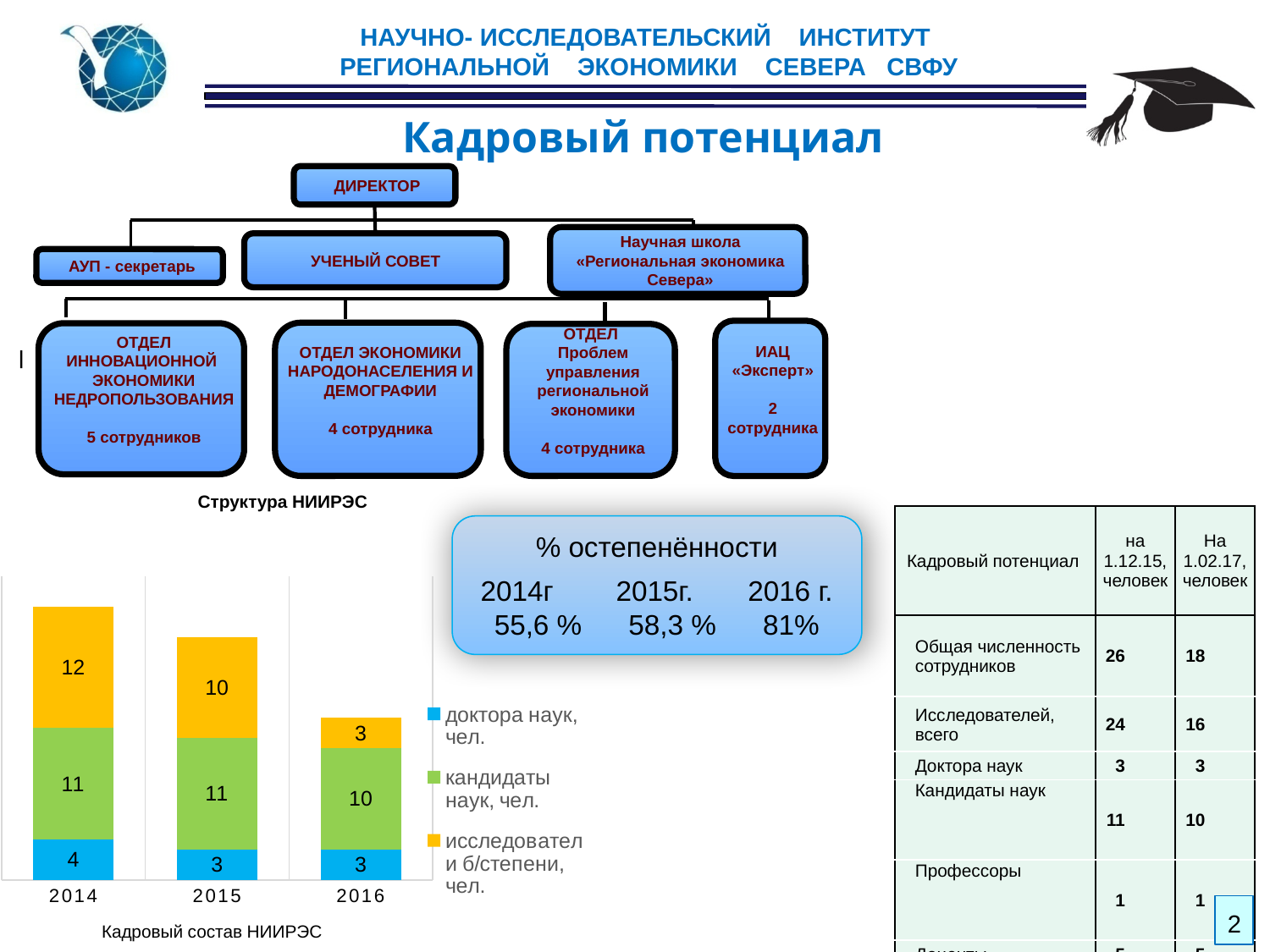
In the chart Кадровый состав НИИРЭС, what is the value for доктора наук in 2014? 4 In the chart Кадровый состав НИИРЭС, does the total number of staff rise or fall from 2014 to 2016? fall In the chart Кадровый состав НИИРЭС, what is the value for исследователи б/степени in 2015? 10 In the chart Кадровый состав НИИРЭС, what is the total of the stacked bar for 2014? 27 In the chart Кадровый состав НИИРЭС, which year has the highest value for исследователи б/степени? 2014 In the chart Кадровый состав НИИРЭС, how many years are shown on the x axis? 3 In the chart Кадровый состав НИИРЭС, what is the difference between исследователи б/степени in 2014 and in 2016? 9 In the chart Кадровый состав НИИРЭС, what is the value for кандидаты наук in 2016? 10 What kind of chart is shown at the bottom left of the slide (Кадровый состав НИИРЭС)? stacked bar chart In the chart Кадровый состав НИИРЭС, which year has the lowest value for исследователи б/степени? 2016 In the chart Кадровый состав НИИРЭС, what is the total of the stacked bar for 2016? 16 In the chart Кадровый состав НИИРЭС, how many series does the legend list? 3